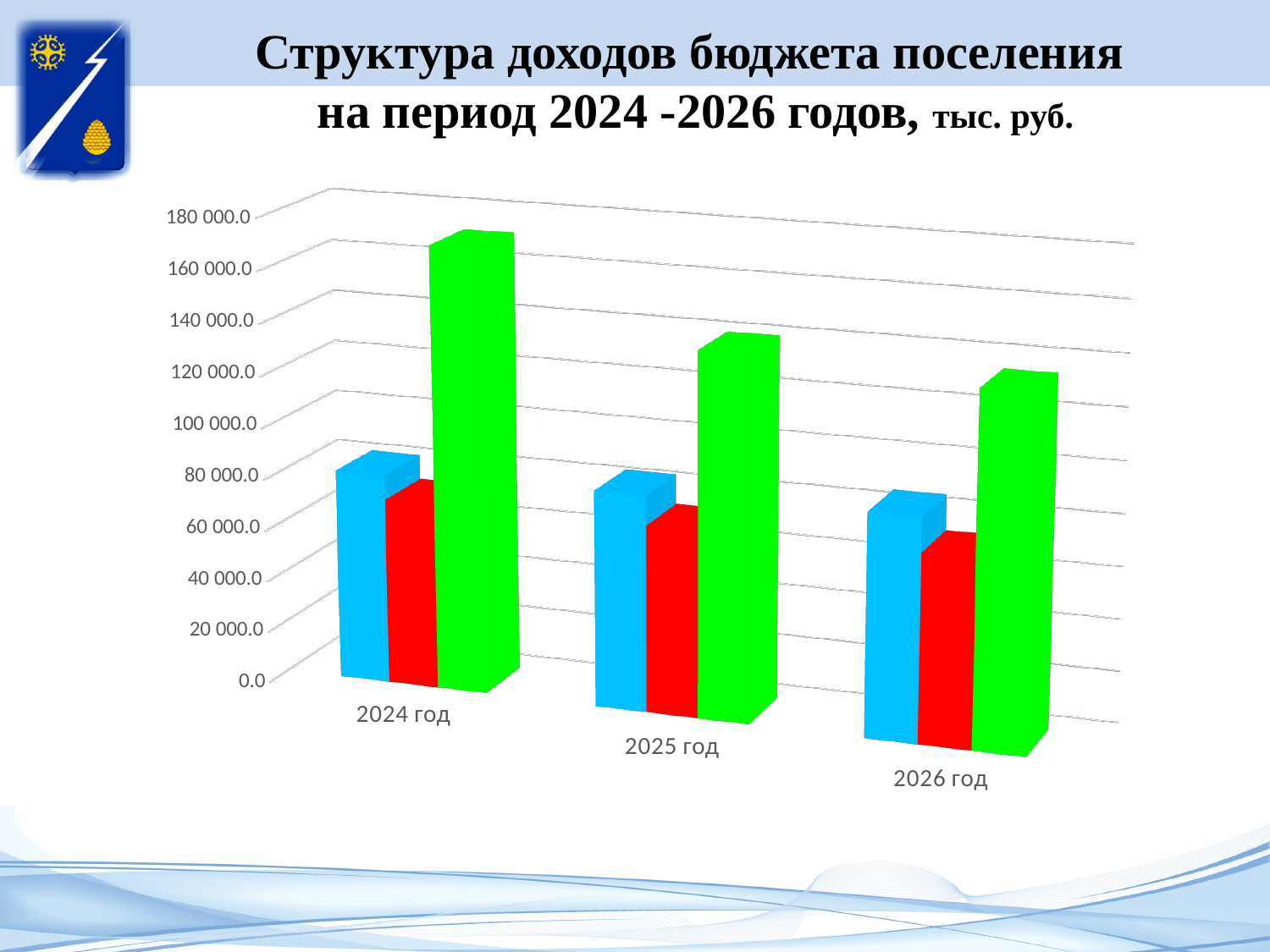
What kind of chart is shown on the slide? bar chart For 2025 год, which bar is taller, the blue one or the red one? the blue one Is the red bar for 2026 год greater or less than 80 000.0? less How many bars are plotted for each year? 3 Which year has the tallest green bar? 2024 год How many year categories are shown on the x axis? 3 Is the blue bar for 2026 год greater or less than 100 000.0? less What is the title of the slide's chart? Структура доходов бюджета поселения на период 2024 -2026 годов, тыс. руб. Is the green bar for 2024 год greater or less than 140 000.0? greater Which year has the shortest green bar? 2026 год Do the green bars rise or fall from 2024 год to 2026 год? fall